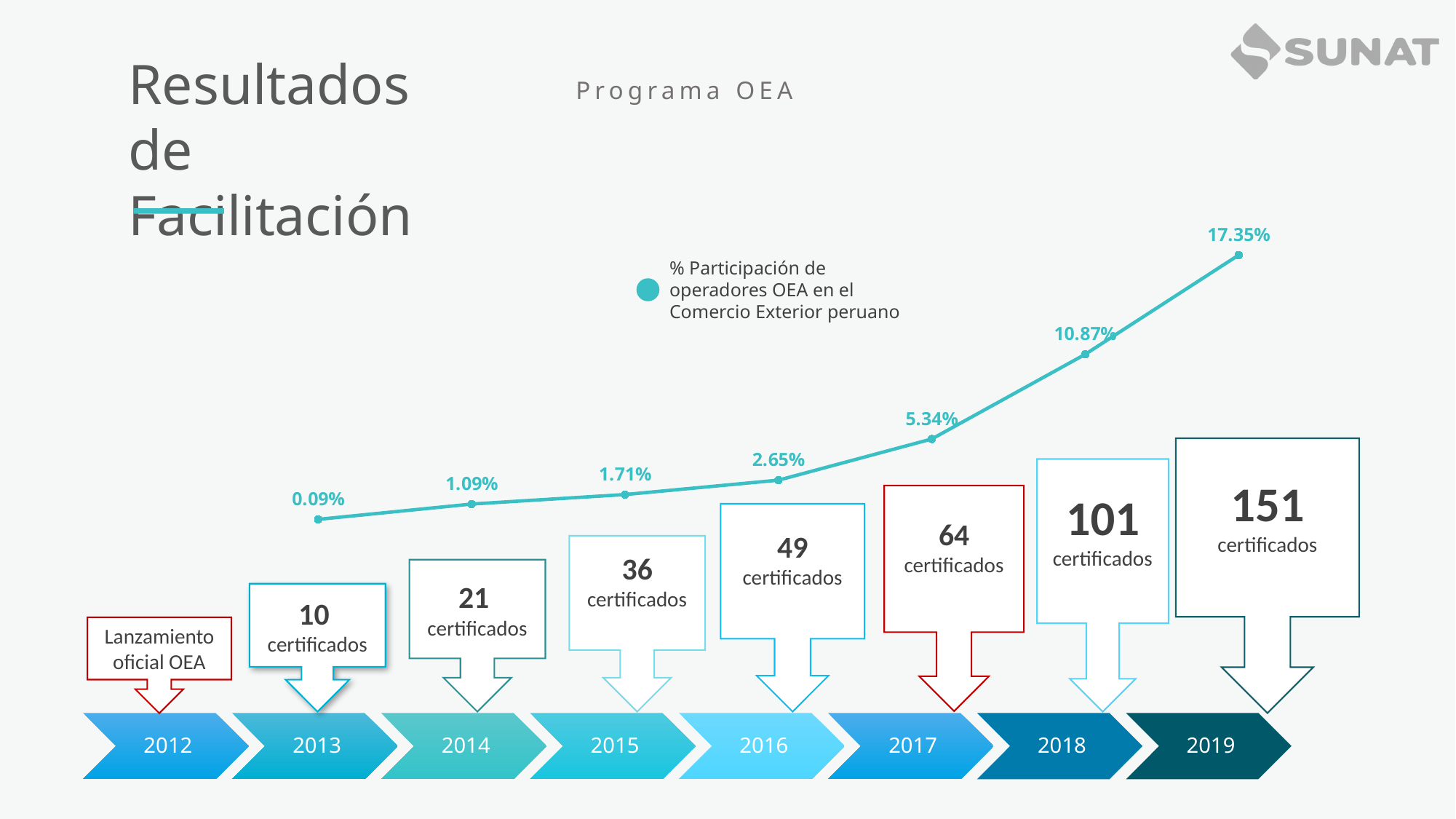
How many data points are plotted on the % participation line? 7 Which year has the lowest % participation of OEA operators on the line chart? 2013 Does the % participation of OEA operators rise or fall from 2013 to 2019? Rise What is the % participation of OEA operators in Peruvian foreign trade shown for 2019? 17.35% How many series does the legend of the line chart list? 1 What is the % participation value plotted for 2014? 1.09% Which year has a larger % participation value, 2016 or 2017? 2017 Which year has the highest % participation of OEA operators on the line chart? 2019 How many certificates are shown for 2018 on the timeline? 101 certificados What is the % participation value plotted for 2016? 2.65% What kind of chart is used to show the % participation of OEA operators? Line chart By how many percentage points did the % participation increase from 2018 to 2019? 6.48